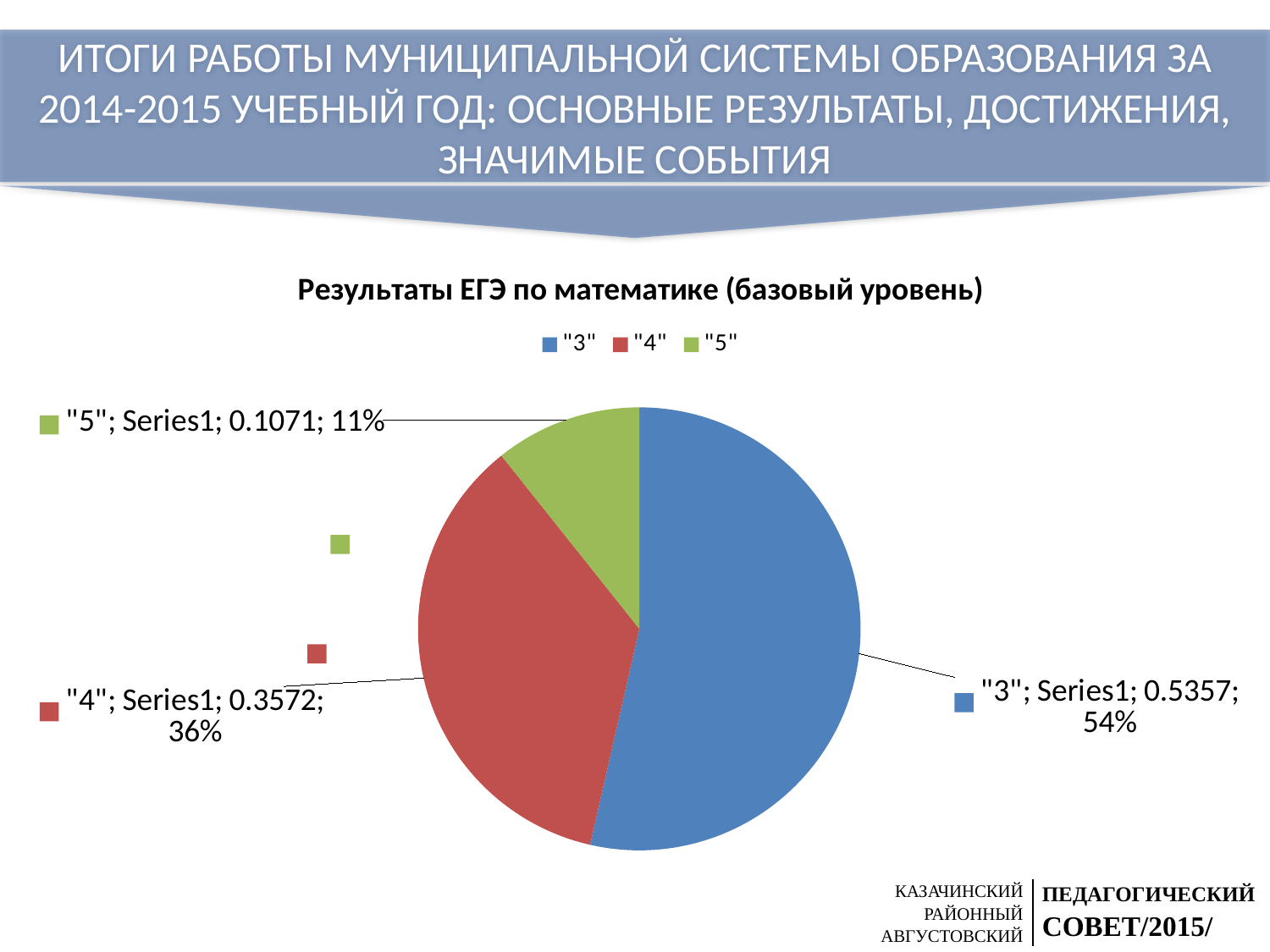
Which category has the smallest slice of the pie? "5" What kind of chart is shown on the slide? pie chart What percentage share does the "4" slice have? 36% Which slice is larger, "4" or "5"? "4" What value is printed on the data label for the "5" slice? 0.1071 What percentage share does the "5" slice have? 11% How many entries does the legend list? 3 What percentage share does the "3" slice have? 54% What is the title of the chart? Результаты ЕГЭ по математике (базовый уровень) What value is printed on the data label for the "3" slice? 0.5357 Which category has the largest slice of the pie? "3" How many slices does the pie chart have? 3